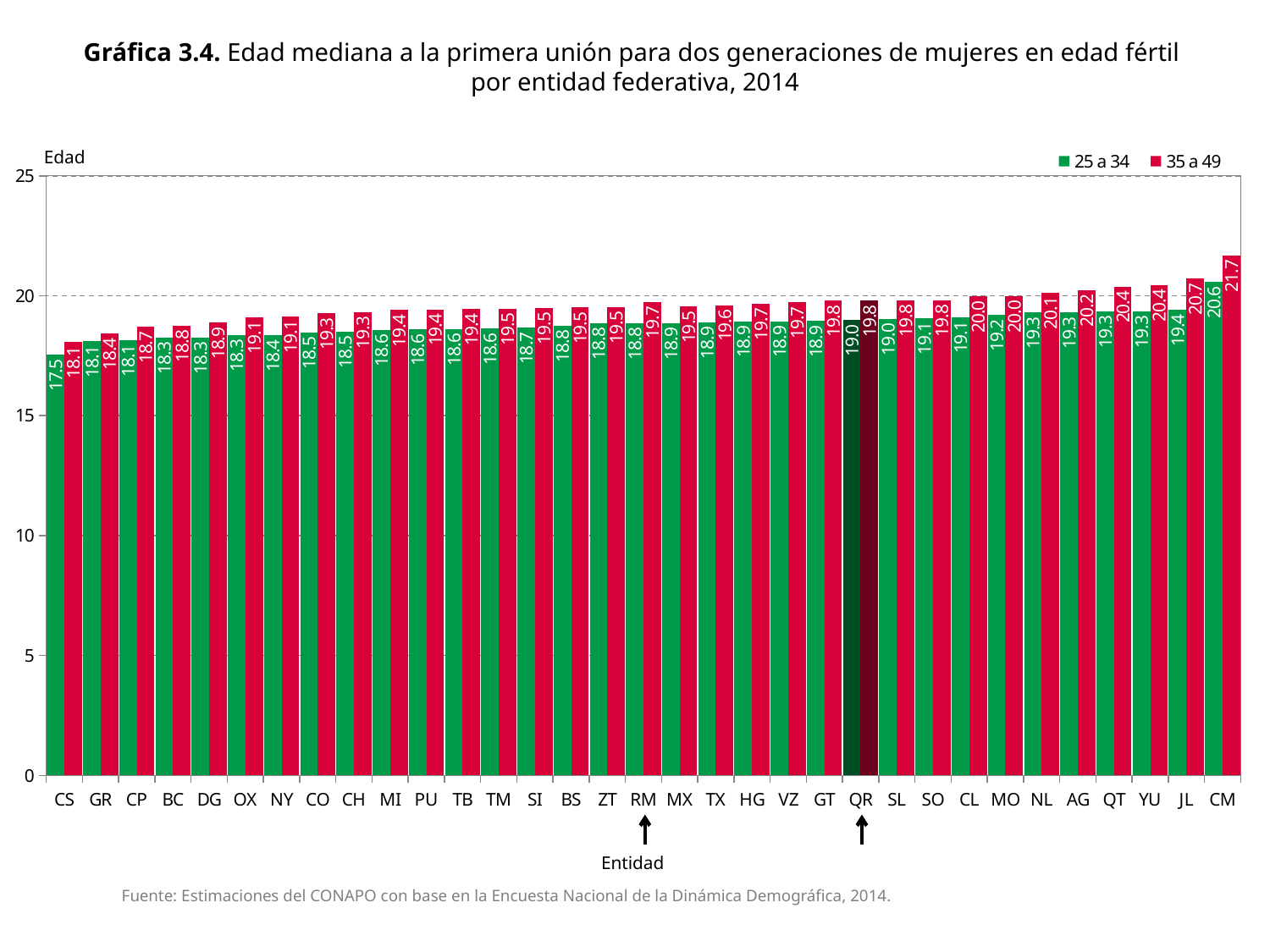
What kind of chart is this? bar chart What is the value for CS in the 25 a 34 series? 17.5 What is the value for CM in the 35 a 49 series? 21.7 What is the difference between the 35 a 49 and 25 a 34 values for JL? 1.3 Which is larger for RM: the 25 a 34 value or the 35 a 49 value? 35 a 49 How many entities are shown on the x axis? 33 What is the value for QR in the 25 a 34 series? 19.0 Which entity has the lowest value in the 25 a 34 series? CS Which entity has the highest value in the 35 a 49 series? CM How many series does the legend list? 2 Is the value for CM in the 25 a 34 series greater or less than 20? greater Do the values in the 35 a 49 series generally rise or fall from left to right along the x axis? rise